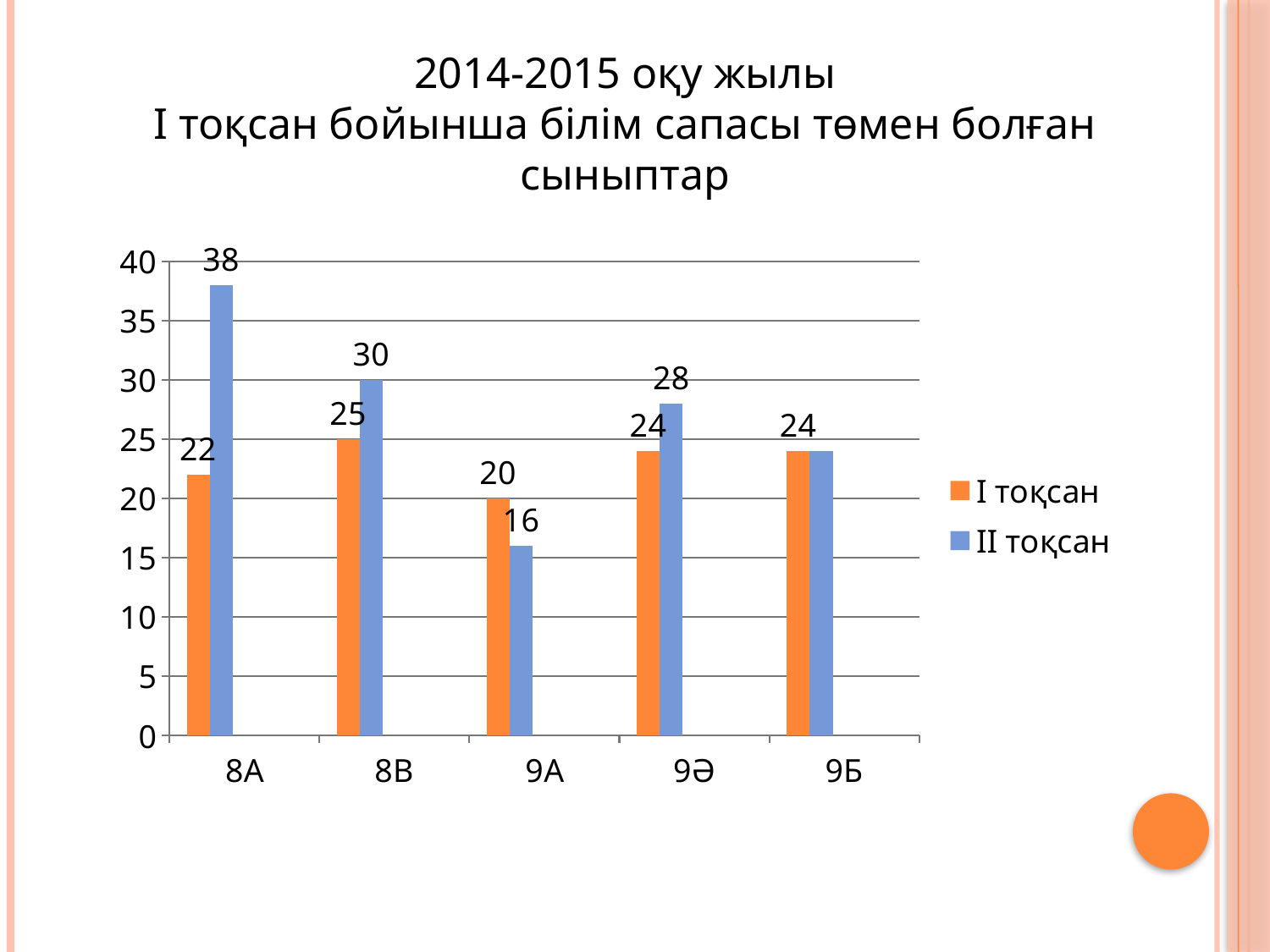
How many series does the legend list? 2 Which category has the lowest value in the II тоқсан series? 9А Which category has the highest value in the II тоқсан series? 8А What is the value for 9А in the II тоқсан series? 16 What is the value for 9Ә in the I тоқсан series? 24 What is the value for 8А in the II тоқсан series? 38 For 9А, which series has the larger value, I тоқсан or II тоқсан? I тоқсан Which category has the lowest value in the I тоқсан series? 9А Is the II тоқсан value for 9Б greater or less than 20? greater What is the difference between the II тоқсан and I тоқсан values for 8А? 16 What is the value for 8А in the I тоқсан series? 22 How many categories are shown on the x axis? 5